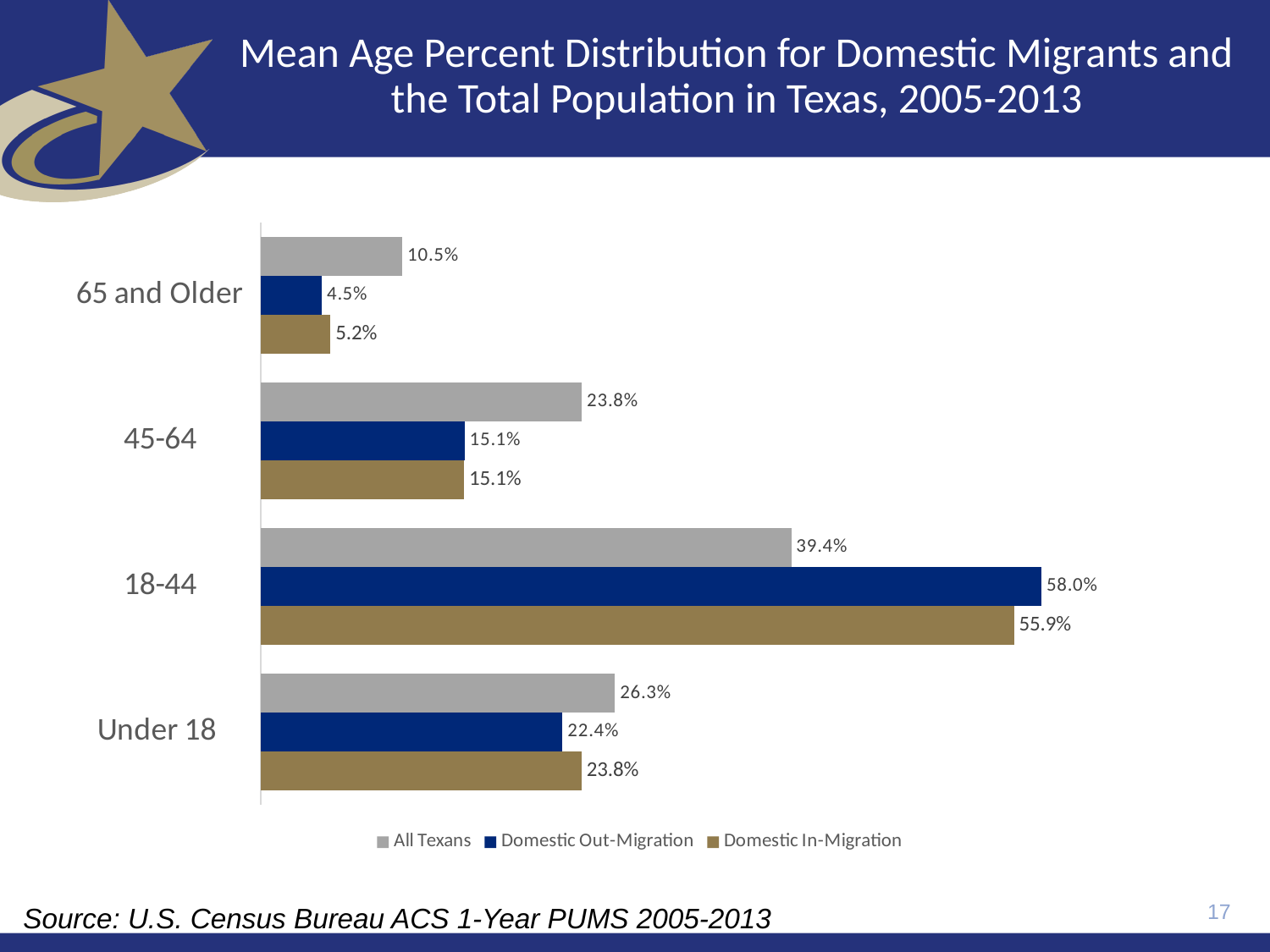
What is the Domestic Out-Migration value for the 18-44 age group? 58.0% What is the Domestic In-Migration value for Under 18? 23.8% What kind of chart is shown on the slide? Bar chart What is the difference between the Domestic Out-Migration and Domestic In-Migration values for the 18-44 age group? 2.1% How many series does the legend list? 3 Which age group has the lowest Domestic Out-Migration value? 65 and Older What is the All Texans value for the 65 and Older age group? 10.5% Which series is shown in gray in the legend? All Texans What is the difference between the All Texans and Domestic Out-Migration values for 65 and Older? 6.0% Which age group has the highest Domestic In-Migration value? 18-44 For the 45-64 age group, which is larger: the All Texans value or the Domestic In-Migration value? All Texans How many age groups are shown on the chart? 4